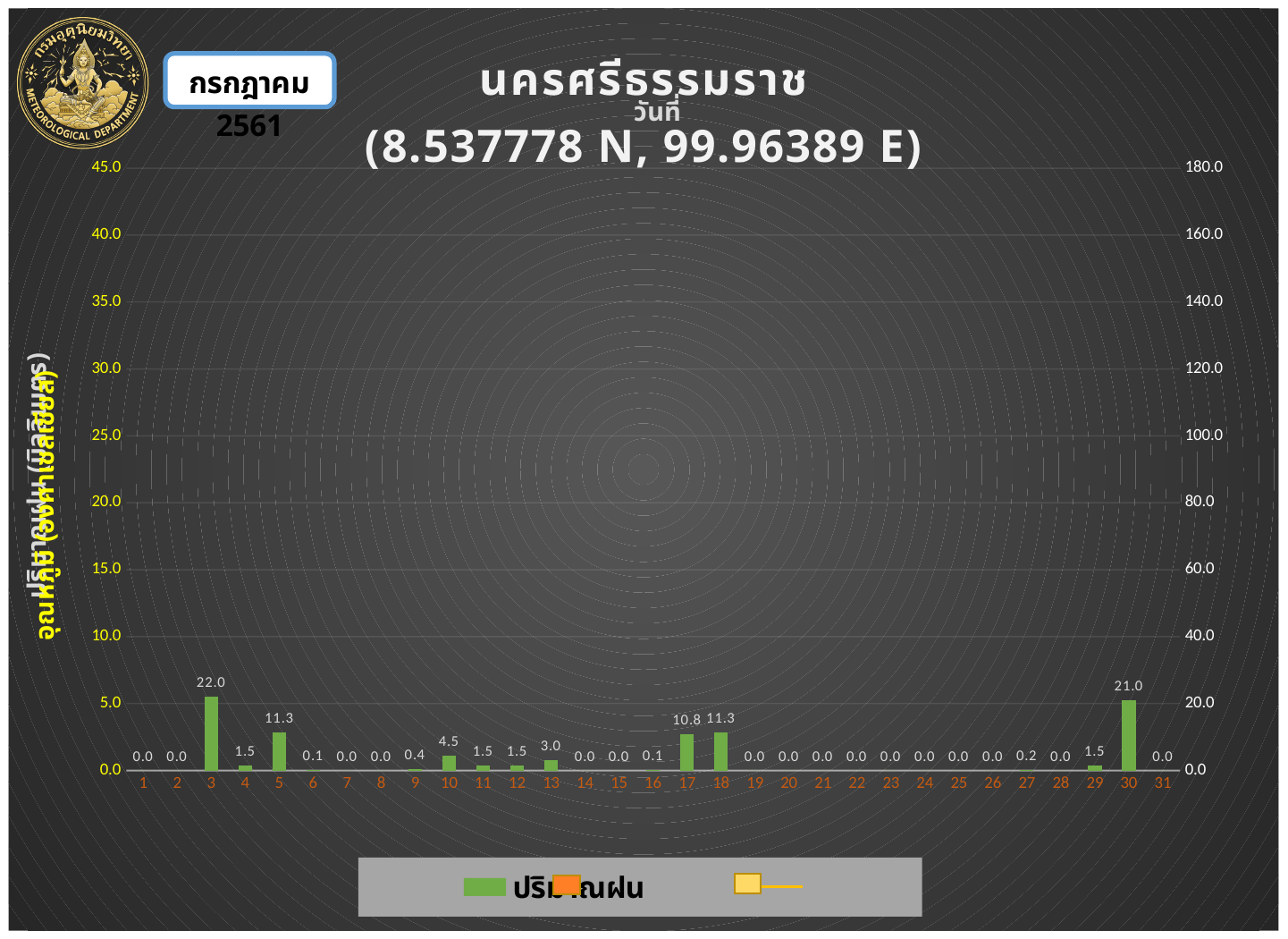
What is the rainfall value for day 30? 21.0 What is the rainfall value for day 10? 4.5 What is the rainfall value for day 17? 10.8 What is the difference between the rainfall values for day 3 and day 30? 1.0 What is the rainfall value for day 5? 11.3 Which has the larger rainfall value, day 5 or day 13? day 5 What is the rainfall value for day 3? 22.0 What is the difference between the rainfall values for day 18 and day 17? 0.5 Which day has the highest rainfall value? 3 What kind of chart is shown on the slide? bar chart What station name is shown in the chart title? นครศรีธรรมราช How many days are shown on the x axis? 31